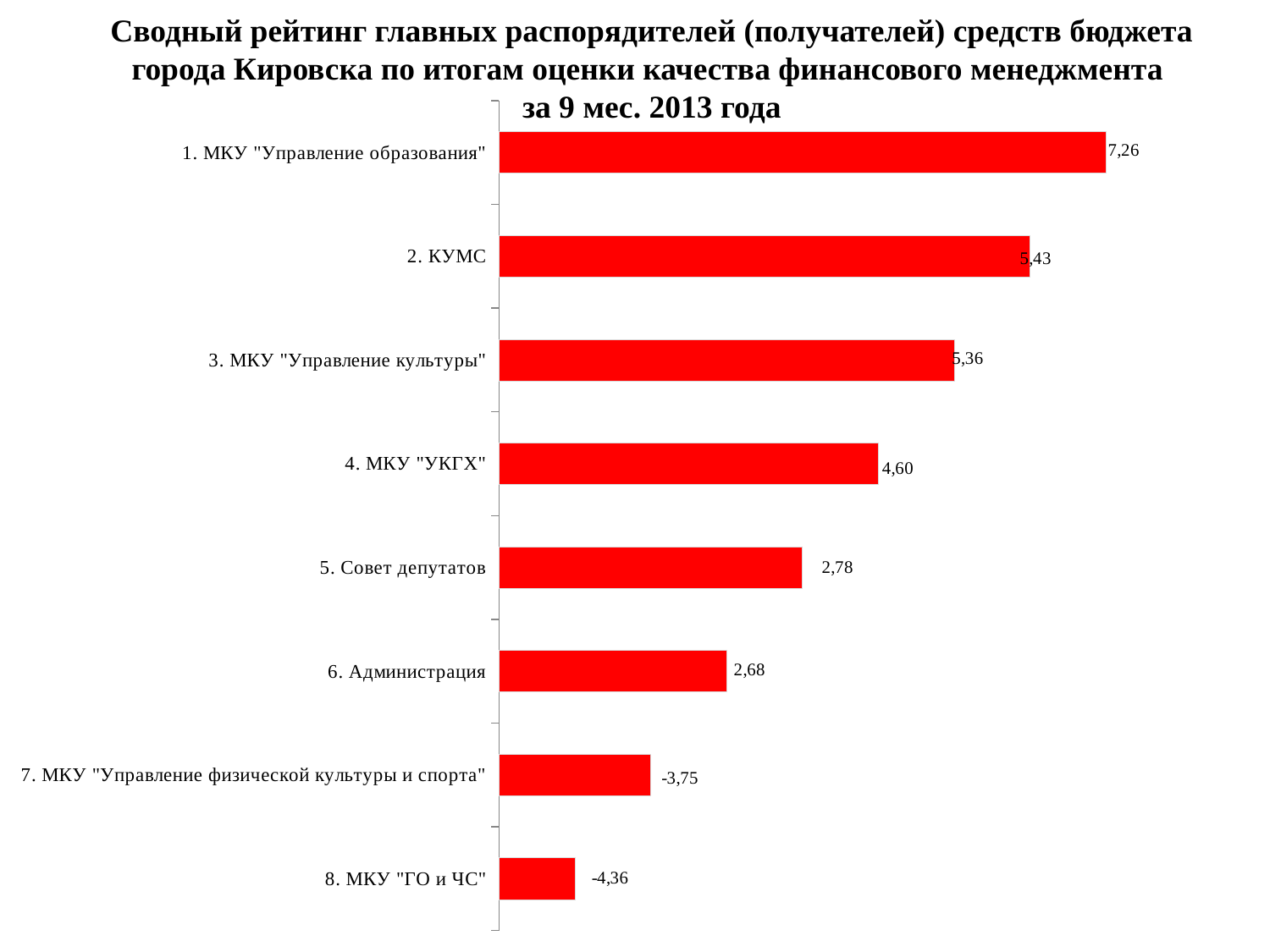
What is the difference between the values for 1. МКУ "Управление образования" and 2. КУМС? 1,83 What is the difference between the values for 4. МКУ "УКГХ" and 5. Совет депутатов? 1,82 What value is shown for 8. МКУ "ГО и ЧС"? -4,36 What value is shown for 4. МКУ "УКГХ"? 4,60 What value is shown for 6. Администрация? 2,68 What value is shown for 1. МКУ "Управление образования"? 7,26 Which category has the lowest value? 8. МКУ "ГО и ЧС" Which has a larger value, 3. МКУ "Управление культуры" or 5. Совет депутатов? 3. МКУ "Управление культуры" What kind of chart is shown on the slide? Bar chart Which category has the highest value? 1. МКУ "Управление образования" How many categories are shown in the chart? 8 What value is shown for 2. КУМС? 5,43